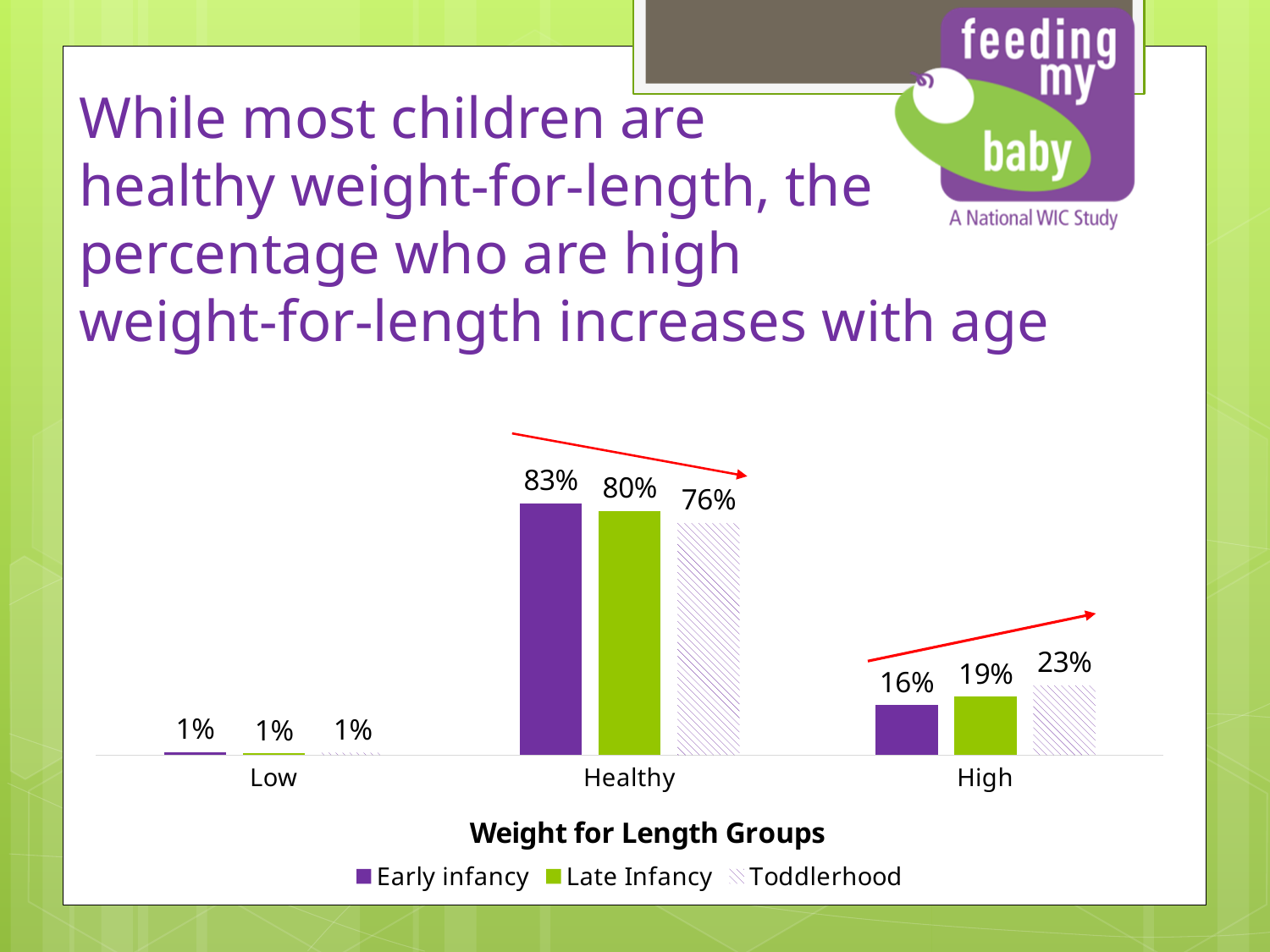
In the High group, which is larger: the Late Infancy value or the Early infancy value? Late Infancy Which weight-for-length group has the lowest value for Early infancy? Low How many weight-for-length groups are shown on the x axis? 3 What is the value for Toddlerhood in the High weight-for-length group? 23% What is the value for Early infancy in the Healthy weight-for-length group? 83% Which weight-for-length group has the highest value for Toddlerhood? Healthy What is the value for Late Infancy in the Low weight-for-length group? 1% What is the difference between the Early infancy and Toddlerhood values in the Healthy group? 7% What is the difference between the Toddlerhood and Early infancy values in the High group? 7% How many series does the legend list? 3 What kind of chart is shown on the slide? Bar chart What is the x-axis title of the chart? Weight for Length Groups